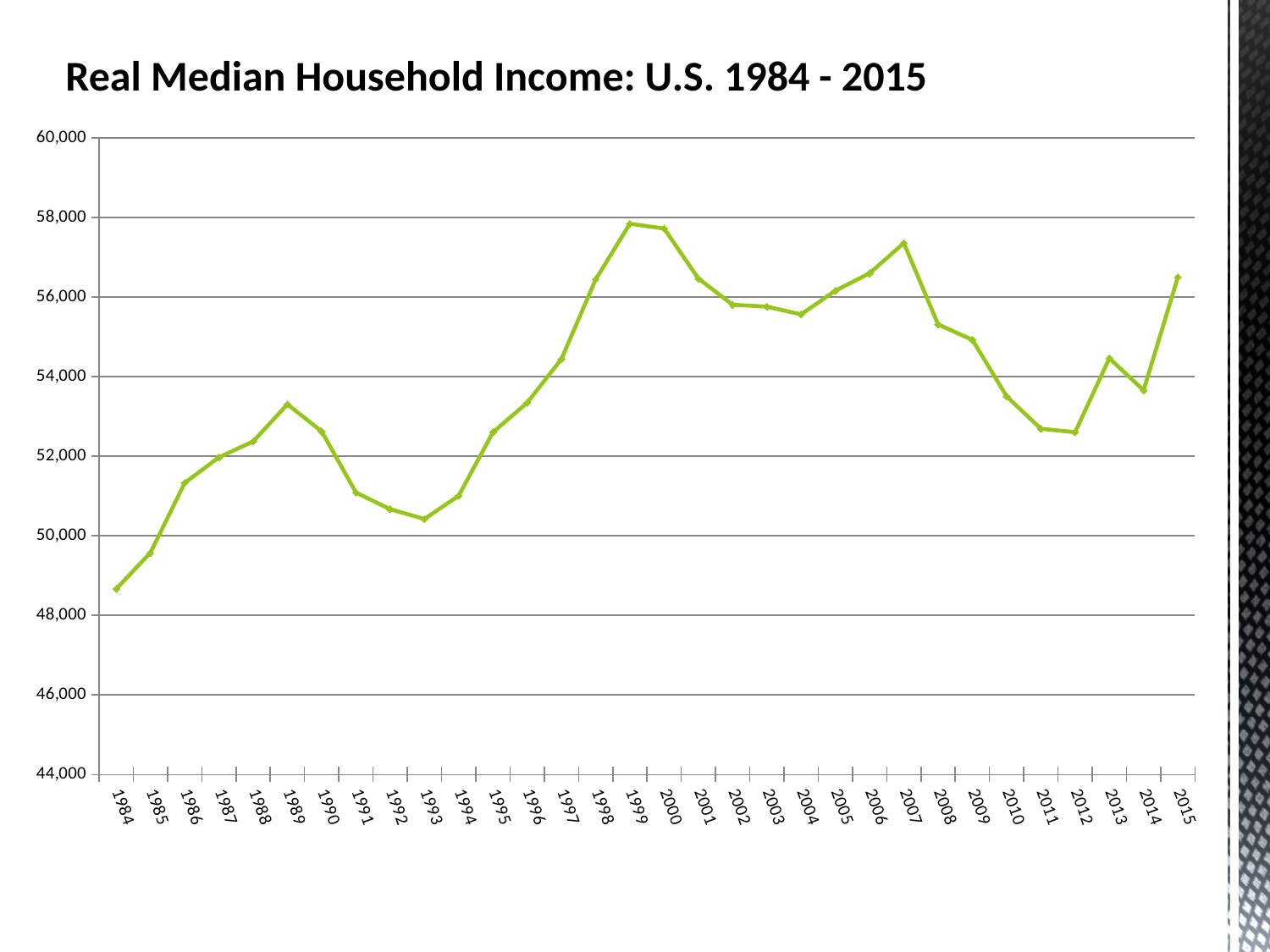
Which year has the higher value, 1989 or 1993? 1989 Is the value for 2015 greater or less than 56,000? greater Does real median household income rise or fall from 1999 to 2004? fall What is the title of the chart? Real Median Household Income: U.S. 1984 - 2015 How many years are plotted on the x axis? 32 In which year is real median household income lowest? 1984 In which year is real median household income highest? 1999 Is the value for 1993 greater or less than 52,000? less Is the value for 2012 greater or less than 54,000? less What kind of chart is shown on the slide? Line chart Which year has the higher value, 2007 or 2008? 2007